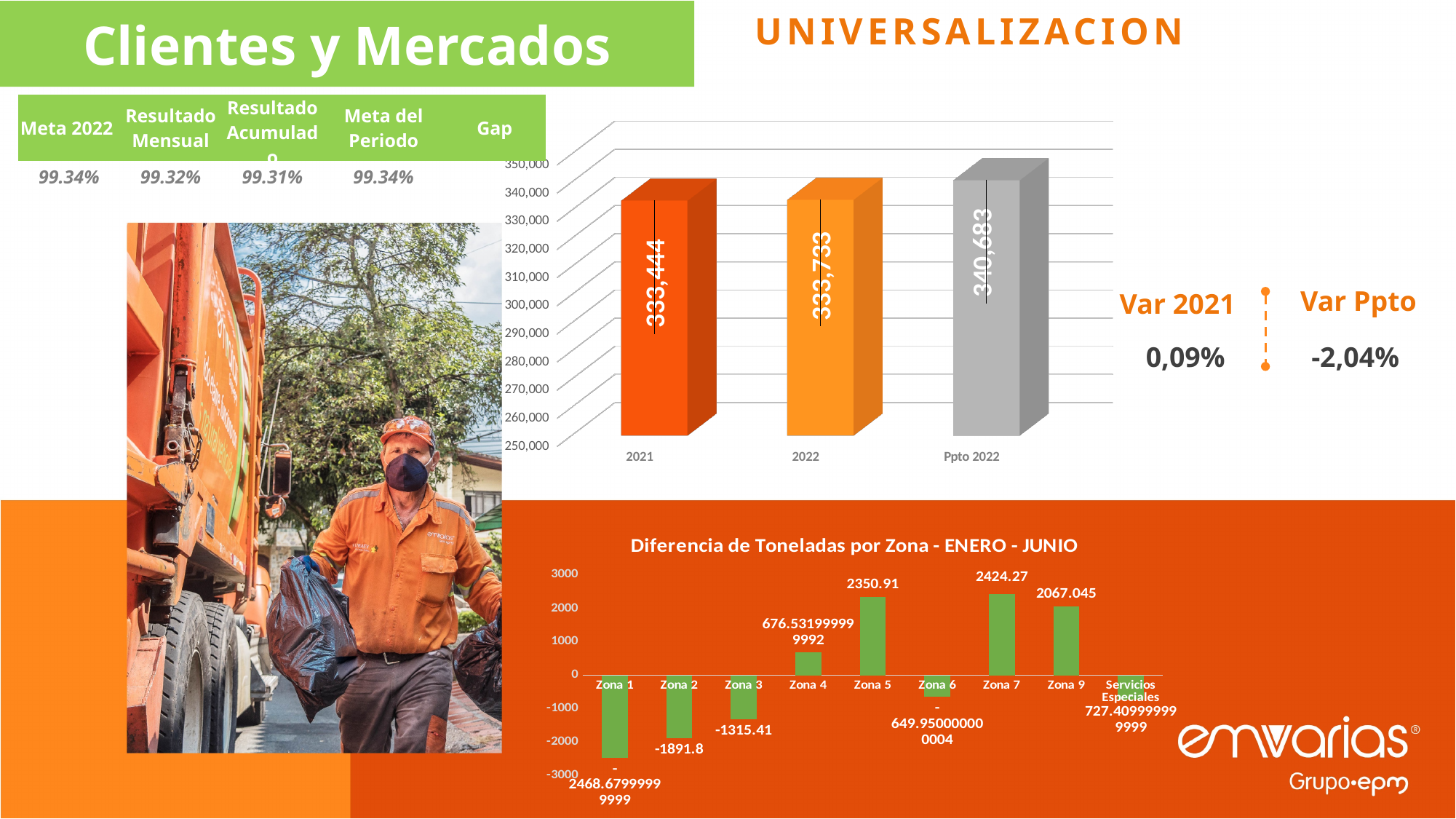
In the chart 'Diferencia de Toneladas por Zona - ENERO - JUNIO', what is the value for Zona 2? -1891.8 In the chart 'Diferencia de Toneladas por Zona - ENERO - JUNIO', which zone has the lowest value? Zona 1 In the top bar chart, what is the value for 2021? 333,444 In the top bar chart, how many bars are plotted? 3 In the chart 'Diferencia de Toneladas por Zona - ENERO - JUNIO', how many categories are shown on the x axis? 9 What kind of chart is the chart titled 'Diferencia de Toneladas por Zona - ENERO - JUNIO'? Bar chart In the top bar chart, what is the value for Ppto 2022? 340,683 In the chart 'Diferencia de Toneladas por Zona - ENERO - JUNIO', what is the value for Zona 9? 2067.045 In the top bar chart, which category has the highest value? Ppto 2022 In the chart 'Diferencia de Toneladas por Zona - ENERO - JUNIO', which is larger, the value for Zona 5 or the value for Zona 3? Zona 5 In the top bar chart, what is the difference between the 2022 value and the 2021 value? 289 In the chart 'Diferencia de Toneladas por Zona - ENERO - JUNIO', what is the value for Zona 7? 2424.27